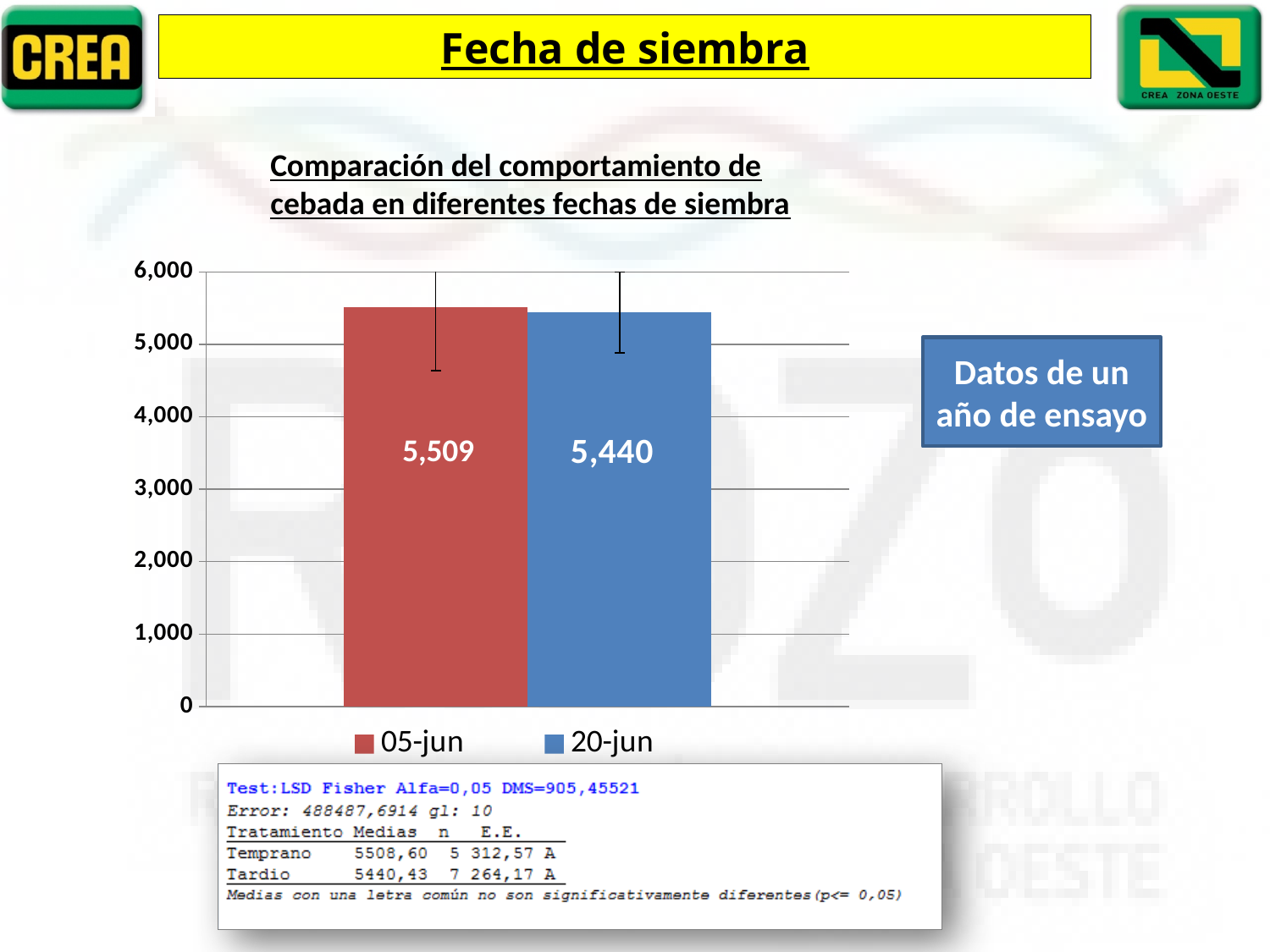
What colour is the bar for 20-jun? blue What is the title of the chart? Comparación del comportamiento de cebada en diferentes fechas de siembra Is the value for 20-jun greater or less than 6,000? less Which sowing date has the lowest value? 20-jun What kind of chart is shown on the slide? bar chart Is the value for 05-jun greater or less than 5,000? greater How many bars are plotted in the chart? 2 What is the value for 20-jun? 5,440 What is the difference between the values for 05-jun and 20-jun? 69 How many series does the legend list? 2 What is the value for 05-jun? 5,509 Which sowing date has the higher value, 05-jun or 20-jun? 05-jun